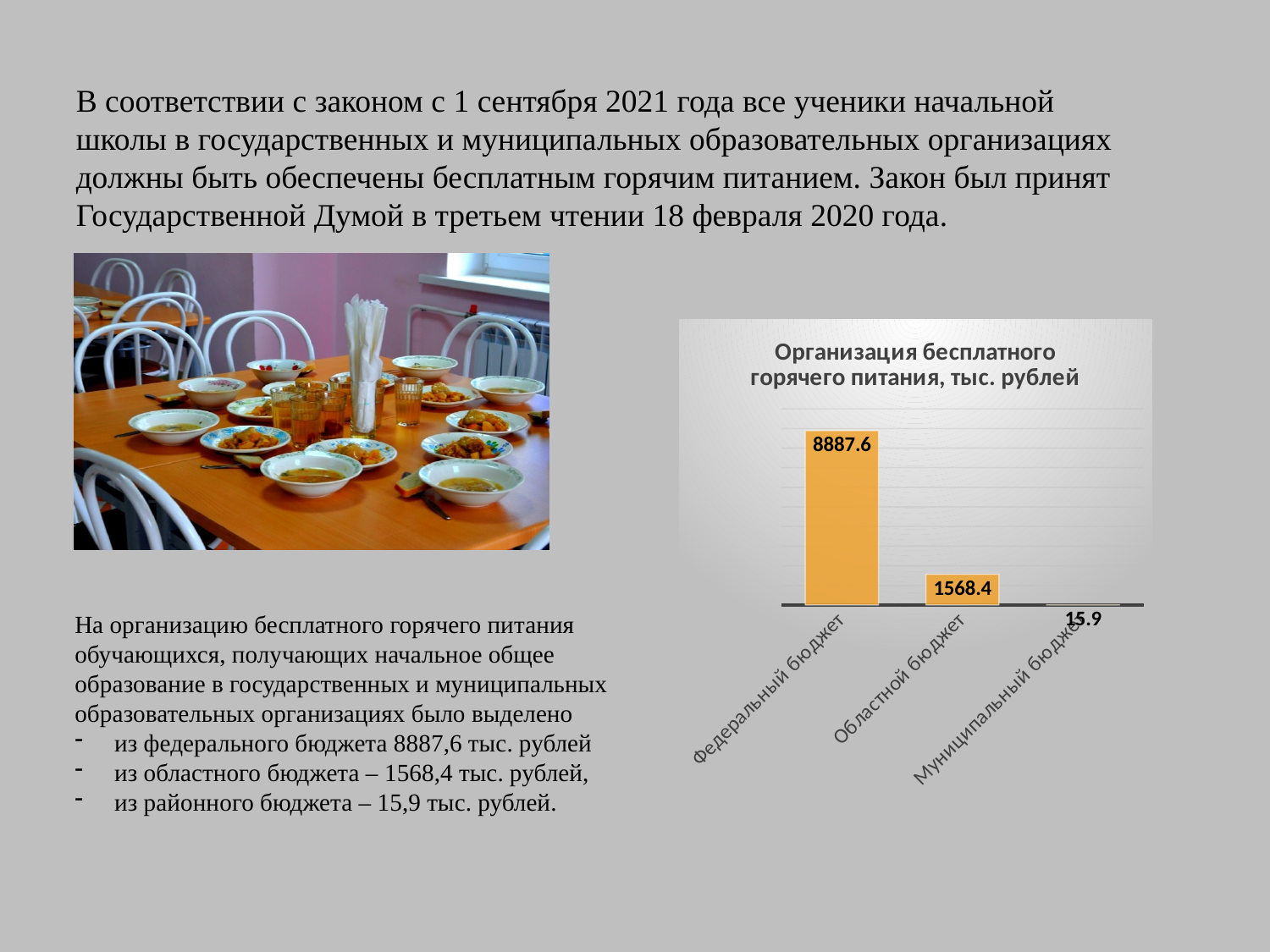
How many categories are shown in the chart? 3 Do the values rise or fall from left to right along the x axis? Fall What kind of chart is shown on the slide? Bar chart What is the value for Областной бюджет? 1568.4 What is the value for Федеральный бюджет? 8887.6 Which category has the highest value? Федеральный бюджет Which category has the lowest value? Муниципальный бюджет What is the difference between the values for Федеральный бюджет and Областной бюджет? 7319.2 What is the title of the chart? Организация бесплатного горячего питания, тыс. рублей Which is larger, the value for Областной бюджет or the value for Муниципальный бюджет? Областной бюджет What is the difference between the values for Областной бюджет and Муниципальный бюджет? 1552.5 What is the value for Муниципальный бюджет? 15.9